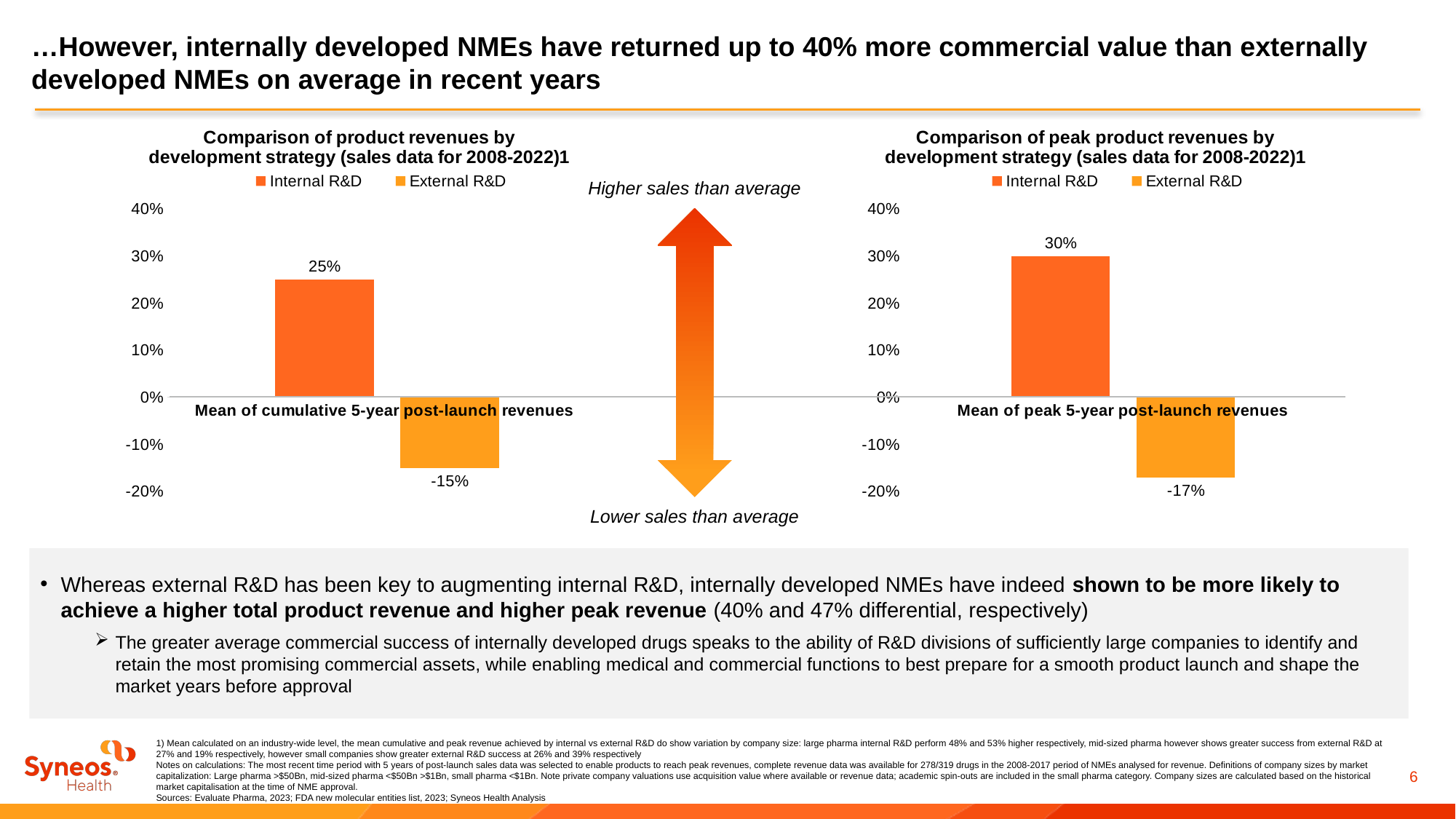
In the left chart, which series has the lowest value? External R&D In the right chart, what is the difference between the Internal R&D and External R&D values? 47 percentage points In the left chart, what is the difference between the Internal R&D and External R&D values? 40 percentage points In the right chart, which series has the higher value, Internal R&D or External R&D? Internal R&D In the left chart (Comparison of product revenues by development strategy), what is the value for Internal R&D? 25% In the right chart (Comparison of peak product revenues by development strategy), what is the value for External R&D? -17% In the right chart, is the value for Internal R&D greater or less than 20%? greater How many series does the legend of the left chart list? 2 What kind of chart is the right chart (Comparison of peak product revenues by development strategy)? Bar chart In the left chart (Comparison of product revenues by development strategy), what is the value for External R&D? -15% In the right chart (Comparison of peak product revenues by development strategy), what is the value for Internal R&D? 30% What is the category label shown on the x axis of the left chart? Mean of cumulative 5-year post-launch revenues